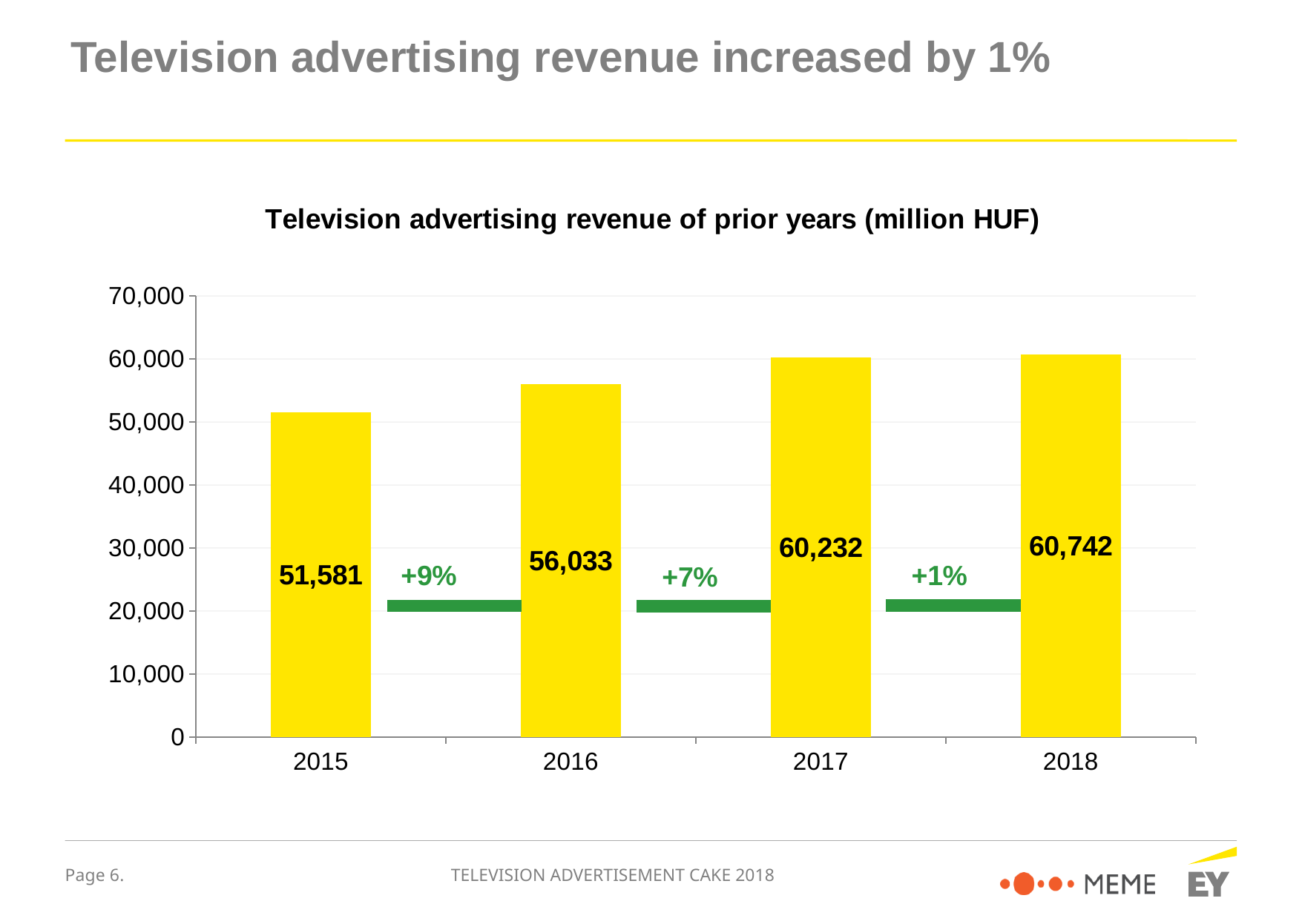
Which year has higher revenue, 2016 or 2017? 2017 Is the value for 2015 greater or less than 50,000? greater How many years are shown on the chart? 4 What is the television advertising revenue for 2016? 56,033 What percentage change is shown between 2017 and 2018? +1% What is the difference in revenue between 2018 and 2015? 9,161 Which year has the highest television advertising revenue? 2018 What kind of chart is shown on the slide? Bar chart What is the television advertising revenue for 2018? 60,742 What is the television advertising revenue for 2015? 51,581 Which year has the lowest television advertising revenue? 2015 What is the difference in revenue between 2017 and 2016? 4,199